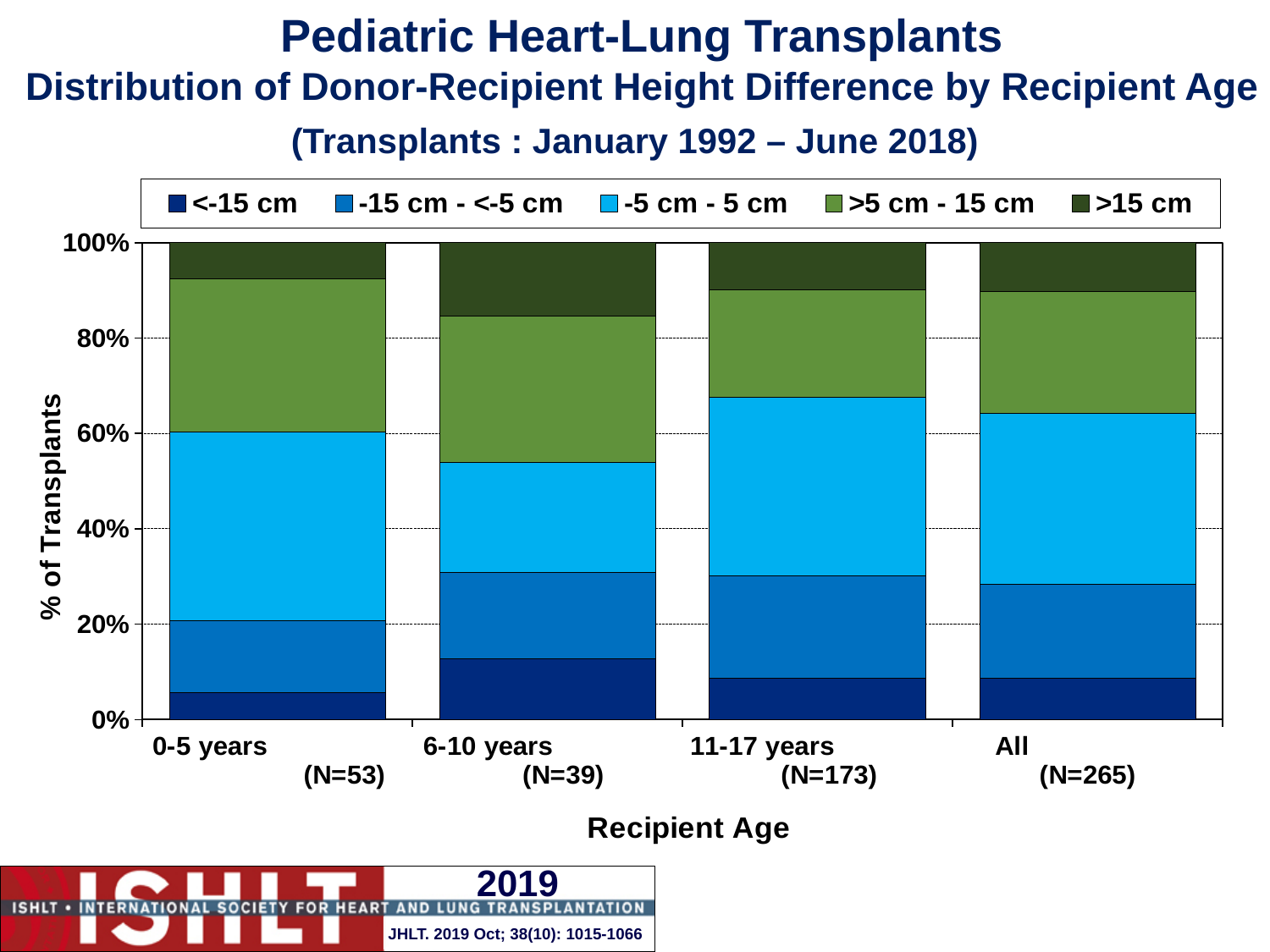
What is the N for the All group? N=265 What kind of chart is shown on the slide? Stacked bar chart How many recipient age categories are shown on the x axis? 4 Which recipient age group has the smallest <-15 cm segment? 0-5 years Which legend entry is shown in the darkest green colour? >15 cm What is the N for the 0-5 years group? N=53 Which recipient age group has the largest <-15 cm segment? 6-10 years Which recipient age group has the largest >15 cm segment? 6-10 years What is the label of the y axis? % of Transplants What is the total height of each stacked bar? 100% Is the <-15 cm segment for 6-10 years greater or less than 20%? less How many series does the legend list? 5